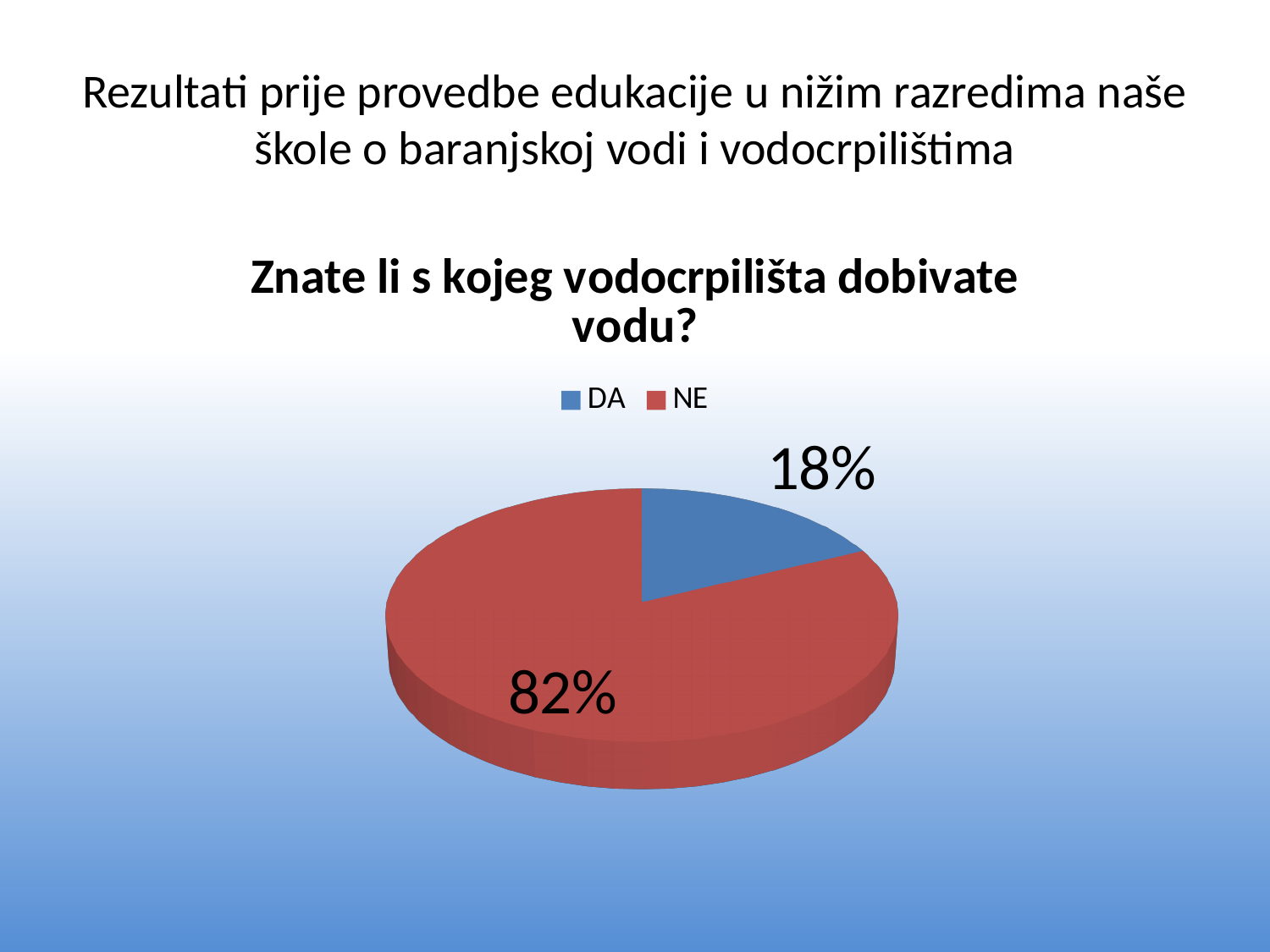
What kind of chart is shown on the slide? Pie chart Which category has the smallest slice of the pie? DA What is the difference in percentage points between the NE and DA slices? 64 How many slices does the pie chart have? 2 What colour is the NE slice in the pie chart? Red Which category has the largest slice of the pie? NE What share of the pie does the NE slice represent? 82% How many entries does the legend list? 2 What is the title of the chart? Znate li s kojeg vodocrpilišta dobivate vodu? Which is larger, the DA slice or the NE slice? NE What share of the pie does the DA slice represent? 18%